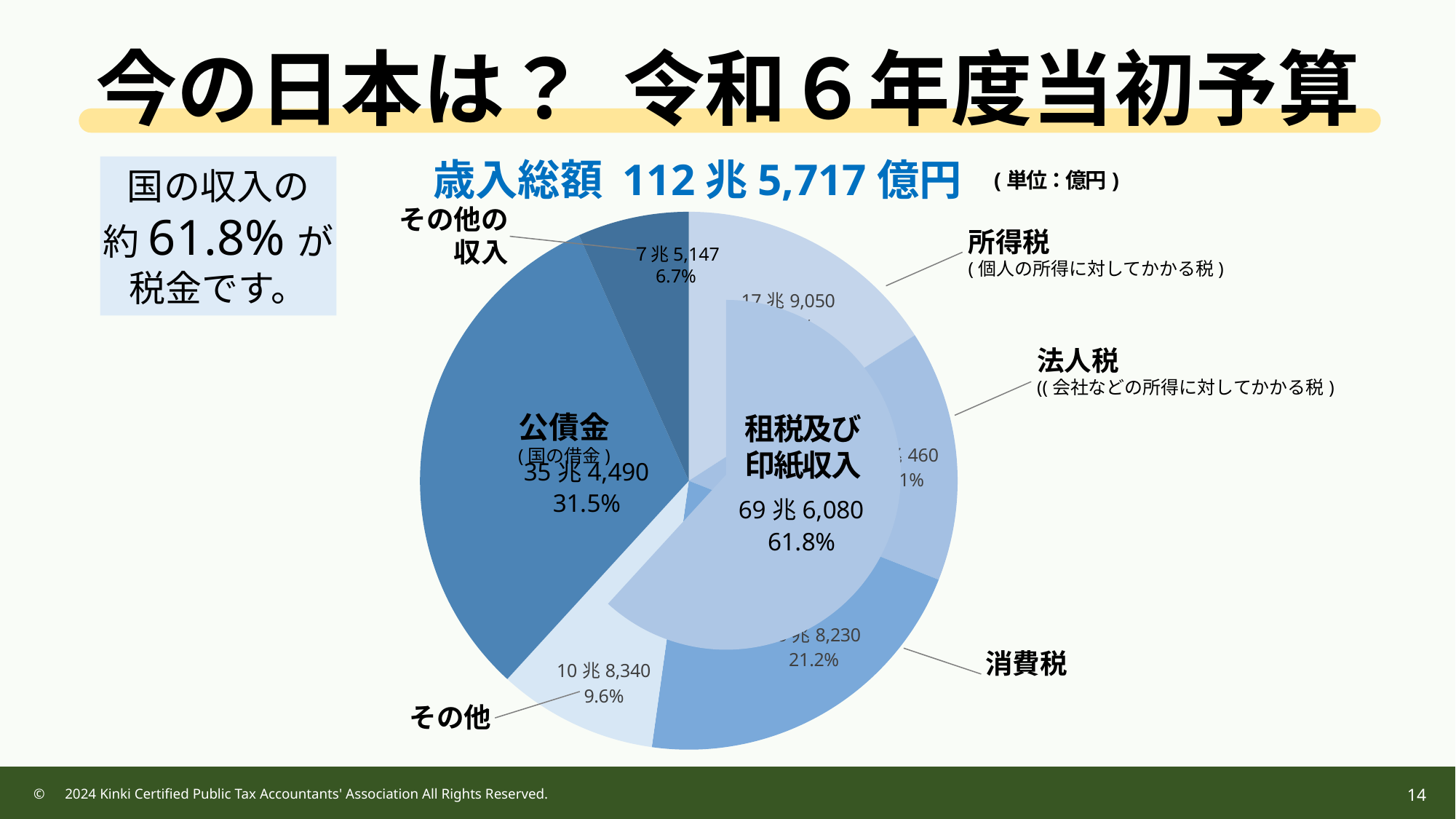
Which slice is larger, 公債金 or その他? 公債金 What percentage share does 消費税 have in the pie chart? 21.2% What is the value shown for 租税及び印紙収入 in the pie chart? 69 兆 6,080 What total revenue (歳入総額) is stated above the pie chart? 112 兆 5,717 億円 What is the value shown for 公債金 in the pie chart? 35 兆 4,490 What is the value shown for 所得税 in the pie chart? 17 兆 9,050 How many labelled slices are in the outer ring of the pie chart? 6 What percentage share does 公債金 have in the pie chart? 31.5% What percentage share does その他の収入 have in the pie chart? 6.7% What is the difference in percentage points between the shares of 公債金 and その他? 21.9 What kind of chart is shown on the slide? pie chart What is the value shown for その他 in the pie chart? 10 兆 8,340